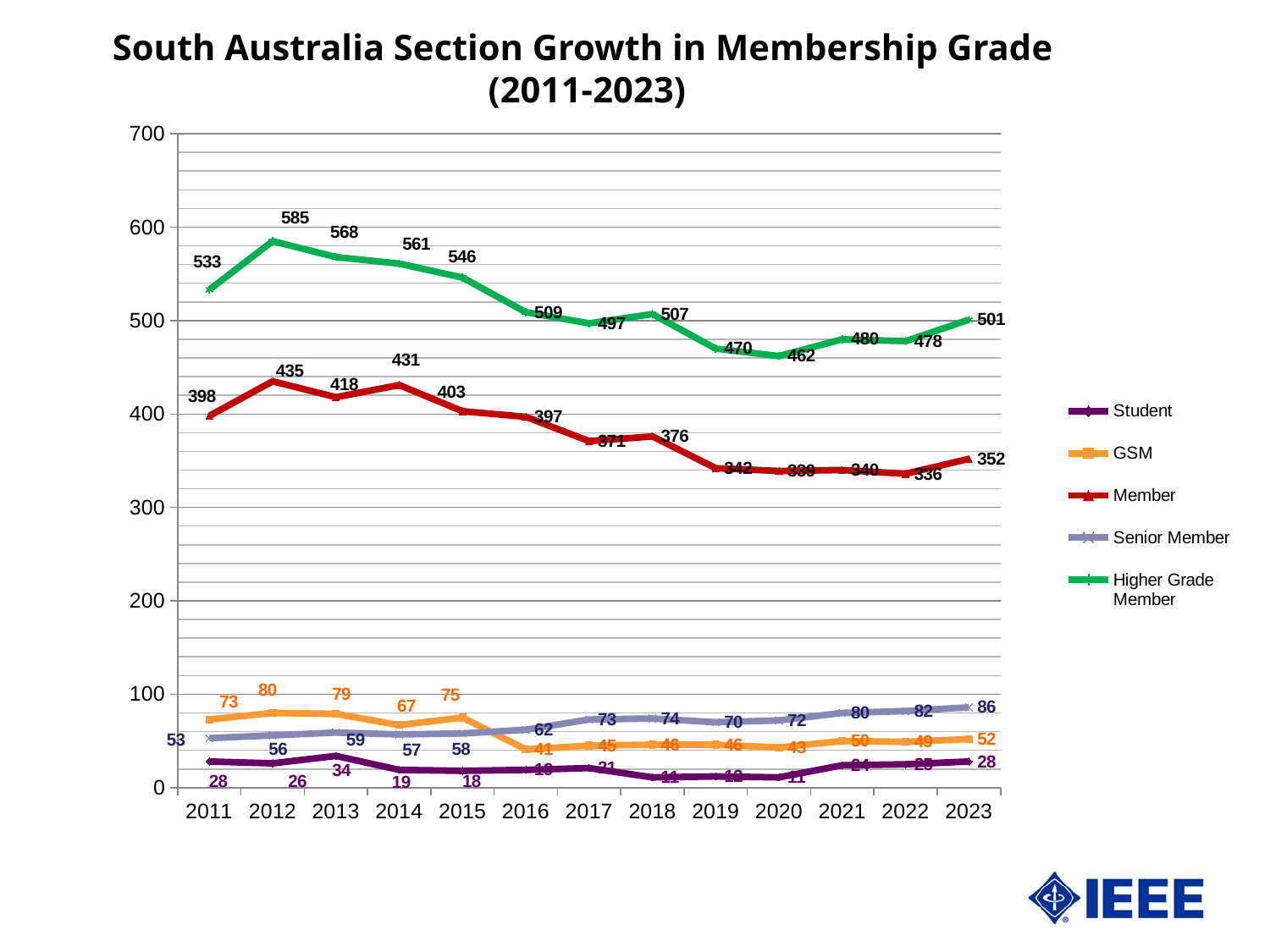
What kind of chart is shown on the slide? line chart What is the difference between the Higher Grade Member values in 2011 and 2023? 32 What was the Higher Grade Member value in 2012? 585 What was the Senior Member value in 2023? 86 In which year was the Higher Grade Member value highest? 2012 Does the Member series overall rise or fall from 2011 to 2023? fall How many years are plotted along the x axis? 13 What is the title of the chart? South Australia Section Growth in Membership Grade (2011-2023) In which year was the Member value lowest? 2022 What was the Member value in 2023? 352 Which was larger in 2012, GSM or Senior Member? GSM How many series does the legend list? 5